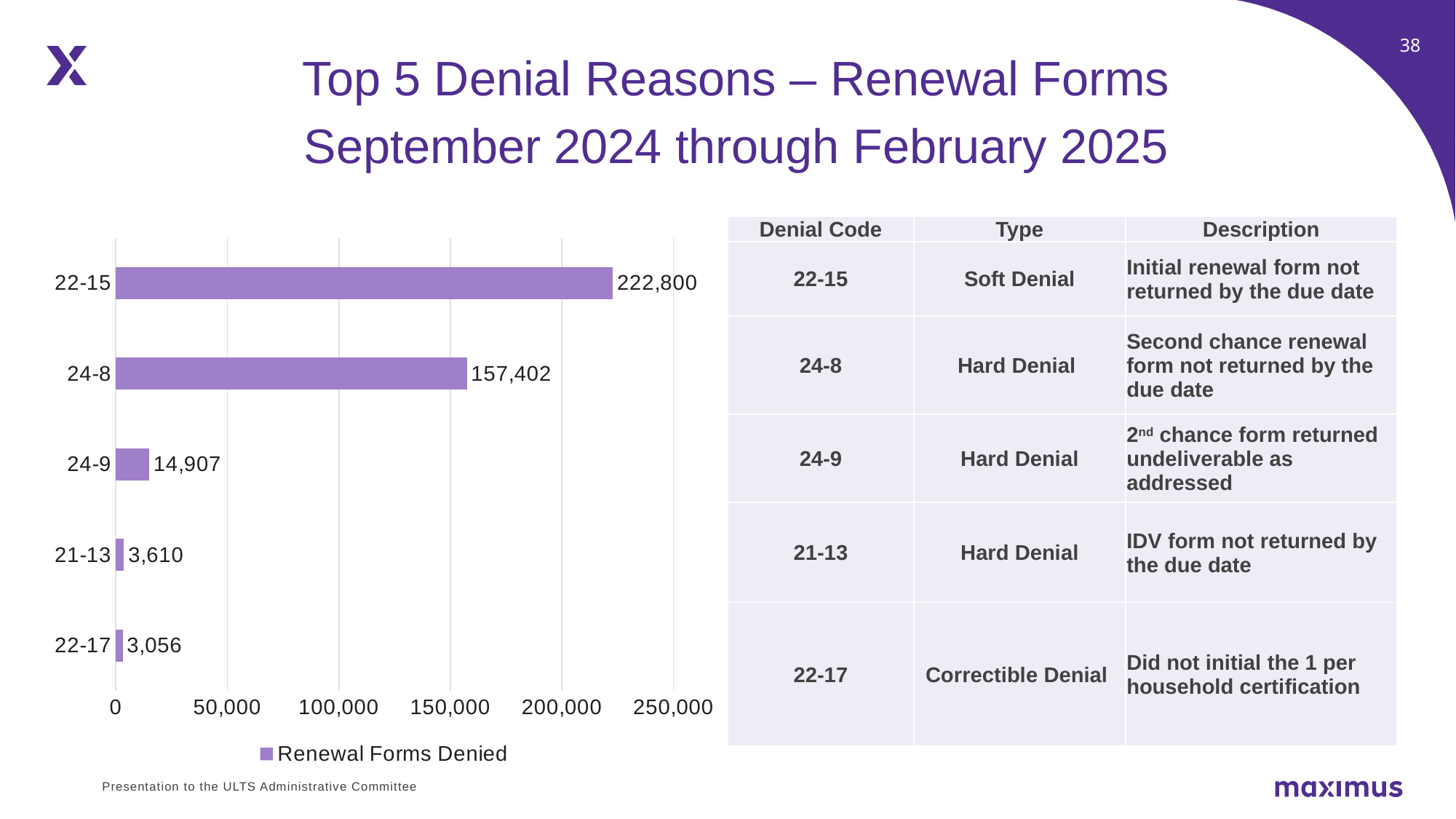
How many renewal forms were denied for denial code 21-13? 3,610 What type of chart is shown on the slide? Bar chart How many renewal forms were denied for denial code 24-8? 157,402 Which denial code has the lowest number of renewal forms denied? 22-17 Which has more renewal forms denied, 24-9 or 21-13? 24-9 Which denial code has the highest number of renewal forms denied? 22-15 How many renewal forms were denied for denial code 24-9? 14,907 Is the value for 24-8 greater or less than 150,000? greater How many renewal forms were denied for denial code 22-15? 222,800 How many denial codes are shown in the bar chart? 5 What is the difference between the renewal forms denied for 22-15 and 24-8? 65,398 What series name does the chart legend show? Renewal Forms Denied